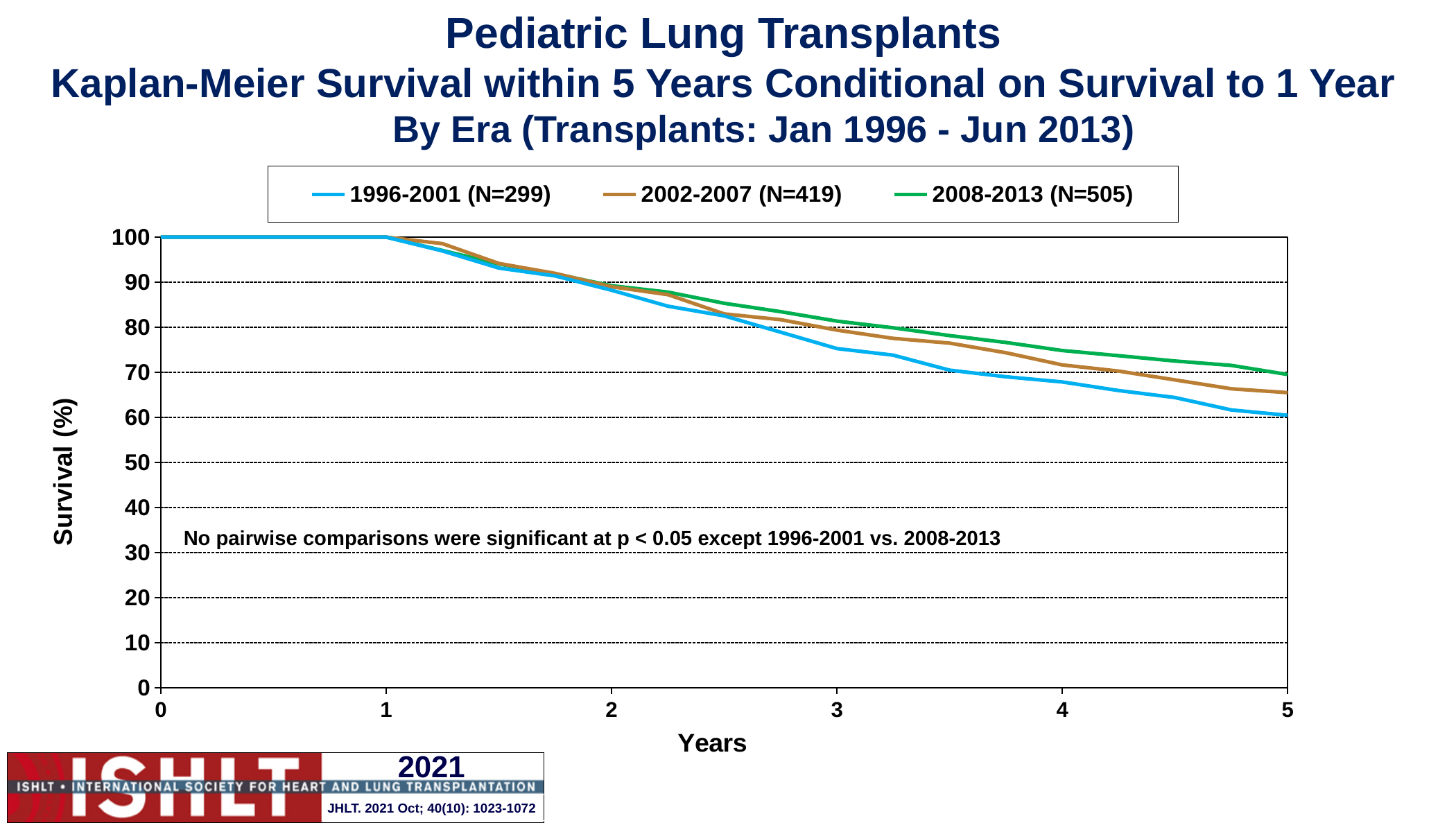
Is the survival for the 1996-2001 era at 3 years greater or less than 70? greater What kind of chart is shown on the slide? line chart What is the survival (%) for the 1996-2001 era at 1 year? 100 Which era has the lowest survival at 5 years? 1996-2001 (N=299) Is the survival for the 1996-2001 era at 4 years greater or less than 70? less Is the survival for the 2002-2007 era at 5 years greater or less than 70? less Which era has the highest survival at 5 years? 2008-2013 (N=505) How many series does the legend list? 3 At 4 years, which era has higher survival: 1996-2001 or 2008-2013? 2008-2013 What is the N for the 2002-2007 era shown in the legend? 419 What is the survival (%) for the 2008-2013 era at 1 year? 100 Do the survival curves rise or fall as years increase from 1 to 5? fall